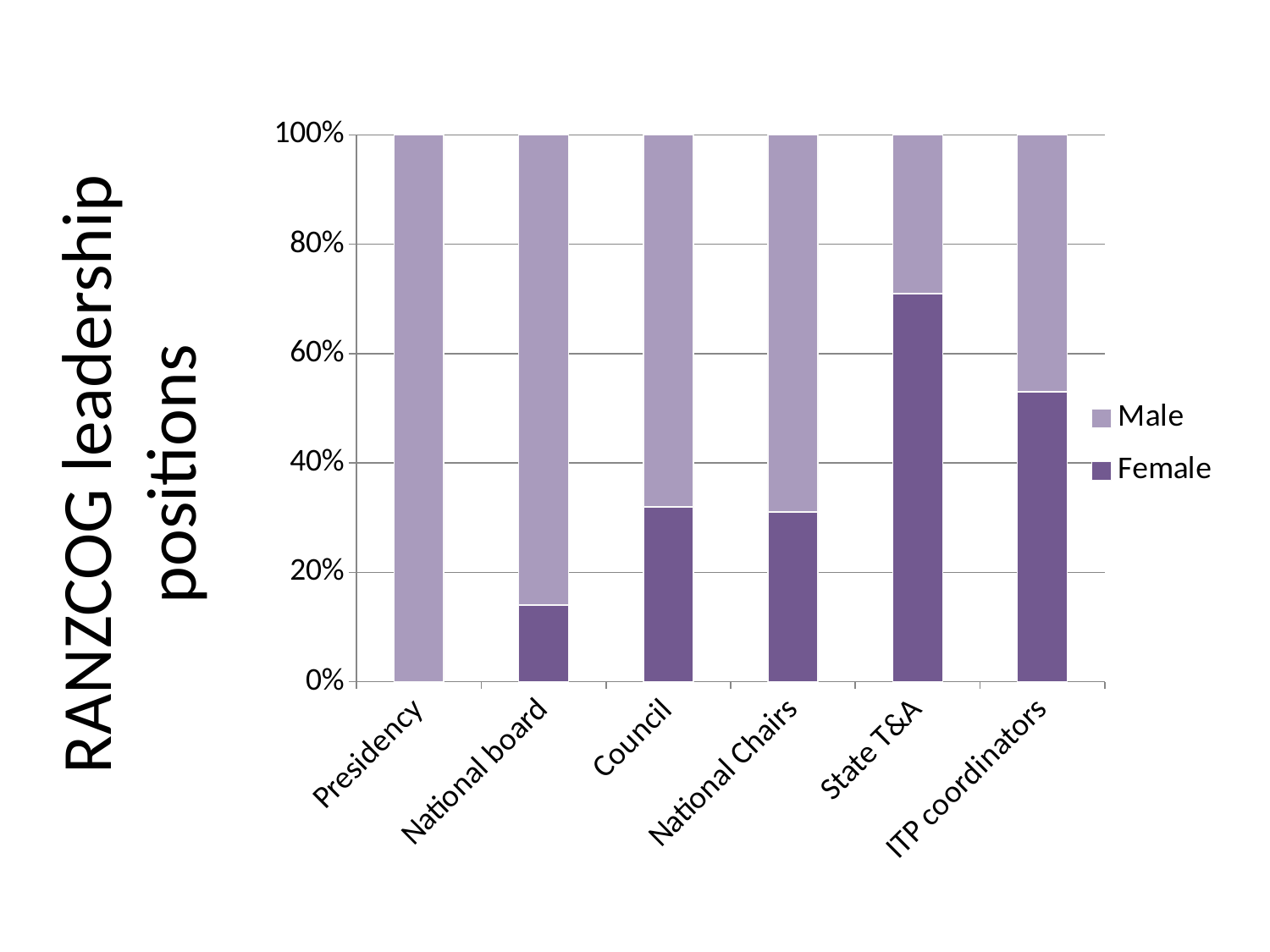
Is the Female share for Council greater or less than 40%? less What kind of chart is shown on the slide? stacked bar chart How many series does the legend list? 2 Which has the larger Female share, State T&A or National board? State T&A Is the Female share for ITP coordinators greater or less than 40%? greater Is the Female share for National board greater or less than 20%? less Which category has the lowest Female share? Presidency Which series is shown in the darker purple colour? Female How many leadership position categories are shown on the x axis? 6 Which category has the highest Female share? State T&A What is the title of the chart? RANZCOG leadership positions